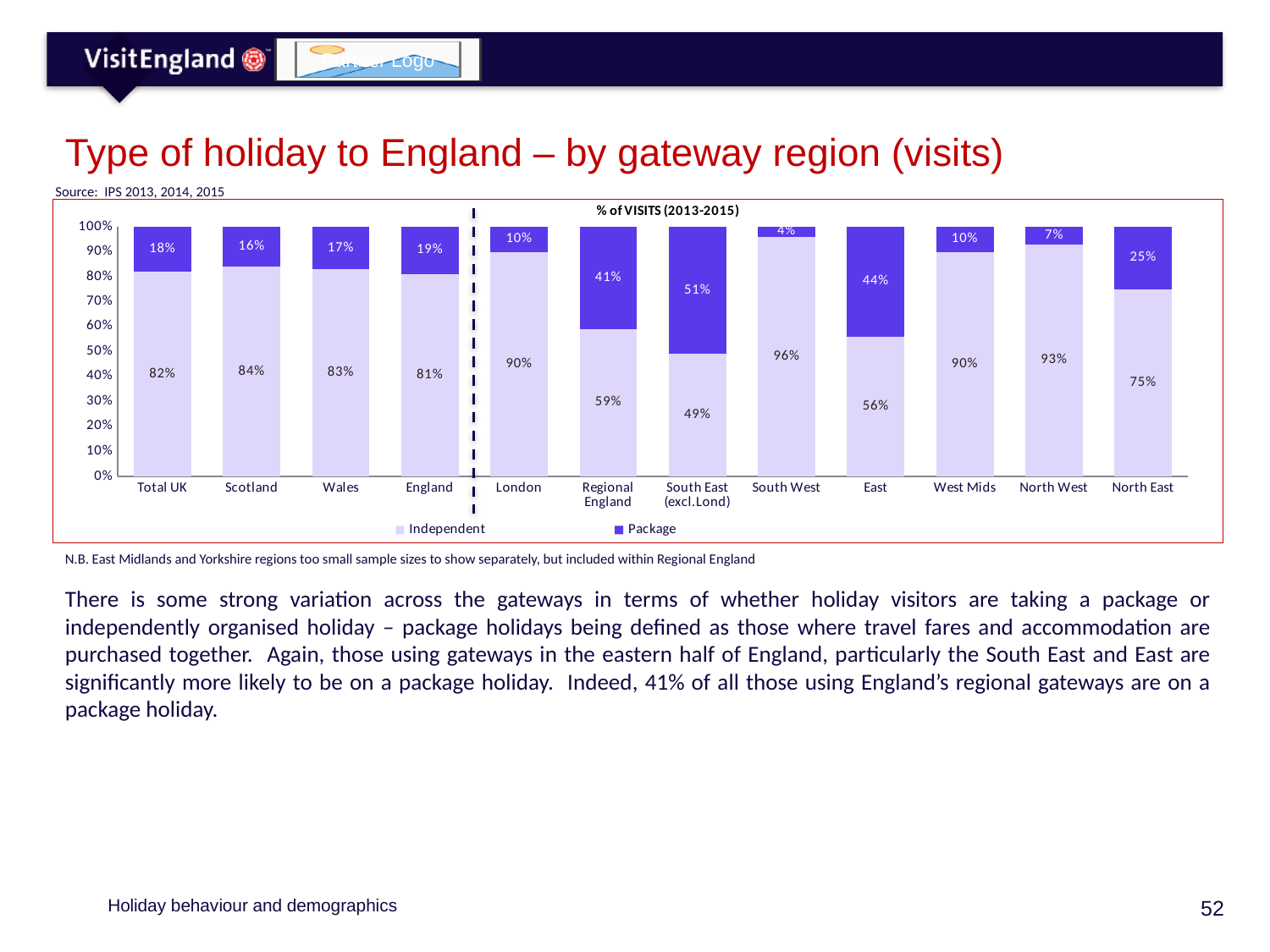
What is the Independent share for Regional England? 59% What is the difference between the Package share for East and the Package share for North East? 19% Which is larger, the Independent share for Scotland or the Independent share for Wales? Scotland Which gateway region has the lowest Package share? South West How many series does the legend list? 2 What is the title shown above the chart plot area? % of VISITS (2013-2015) Which gateway region has the highest Package share? South East (excl.Lond) What is the Independent share for London? 90% Is the Independent share for South East (excl.Lond) greater or less than 50%? less What is the Package share for South East (excl.Lond)? 51% What kind of chart is shown? stacked bar chart How many gateway regions are shown on the x axis? 12